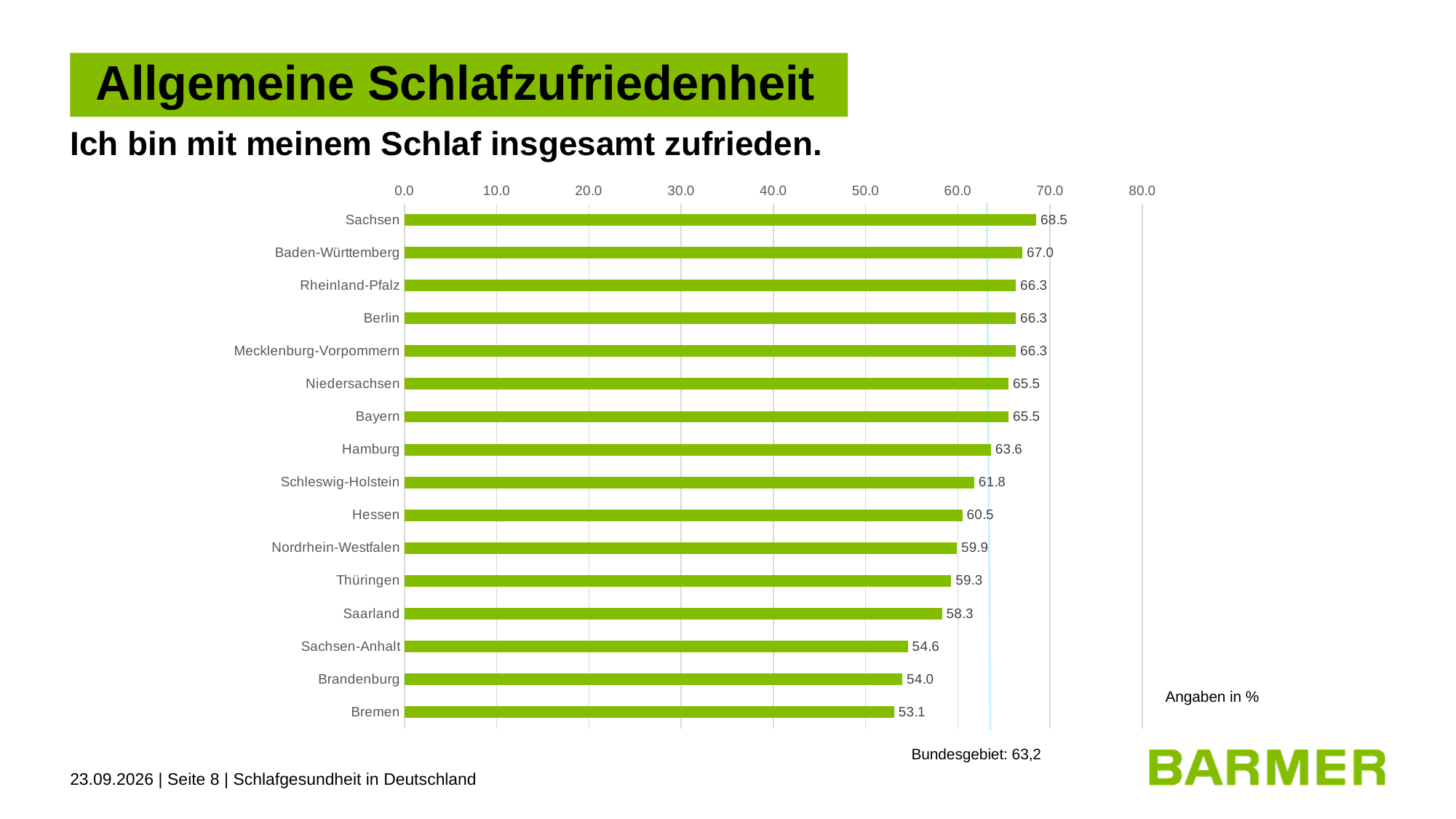
What kind of chart is shown on the slide? bar chart What value is given for the Bundesgebiet below the chart? 63,2 What is the difference between the values for Sachsen and Bremen? 15.4 What is the difference between the values for Baden-Württemberg and Hessen? 6.5 Which federal state has the highest value? Sachsen What is the value for Hamburg? 63.6 What is the value for Sachsen? 68.5 How many federal states are shown in the chart? 16 Which federal state has the lowest value? Bremen Is the value for Sachsen-Anhalt greater or less than 60.0? less Which is larger, the value for Thüringen or the value for Saarland? Thüringen What is the value for Bremen? 53.1